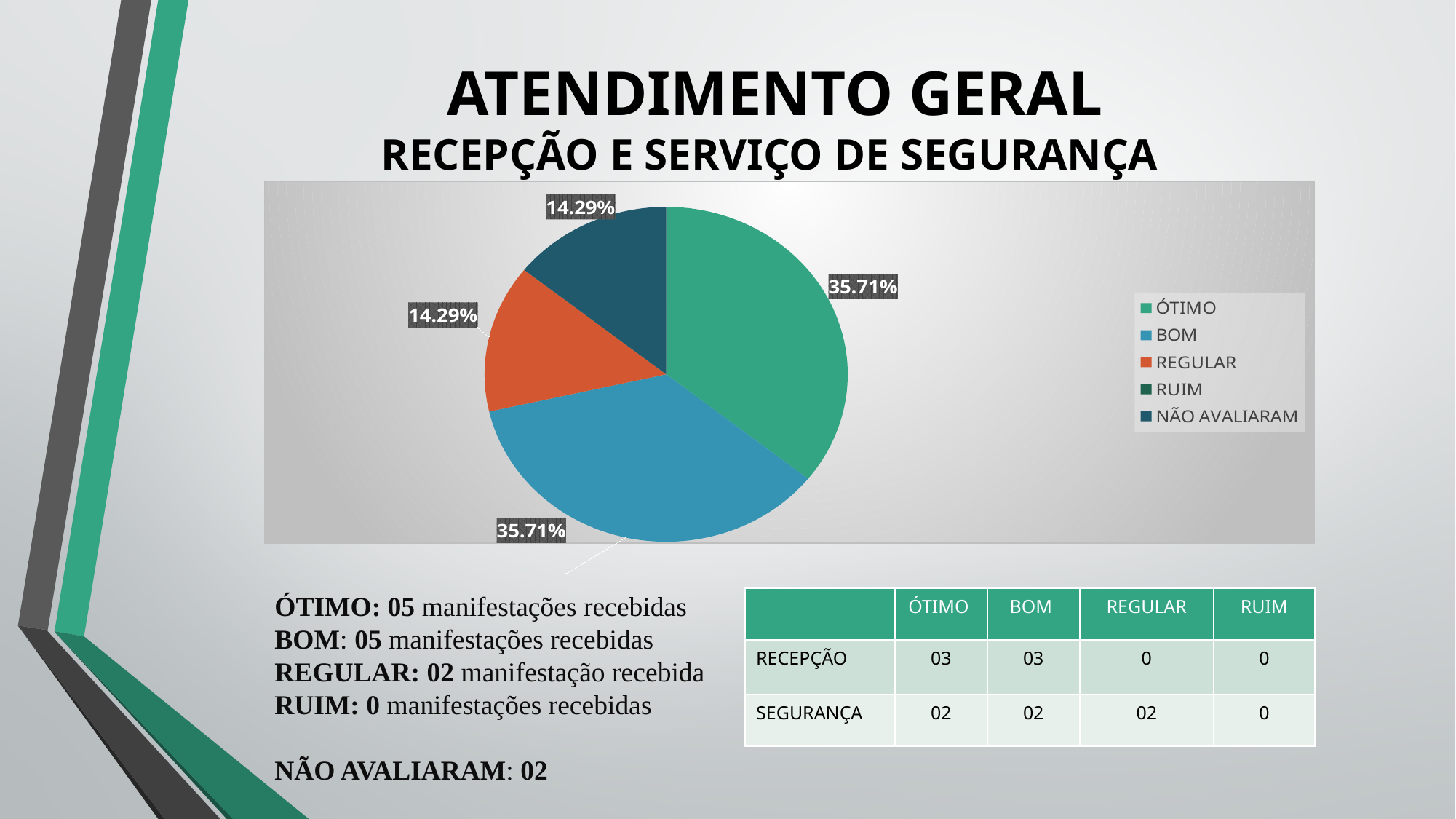
What colour is the ÓTIMO slice in the pie chart? green How many slices are visible in the pie chart? 4 What share of the pie does REGULAR represent? 14.29% Which legend entry of the pie chart is shown in orange? REGULAR Which is larger in the pie chart, ÓTIMO or REGULAR? ÓTIMO What share of the pie does BOM represent? 35.71% What kind of chart is shown on the slide? pie chart What is the difference between the ÓTIMO share and the REGULAR share in the pie chart? 21.42% What share of the pie does NÃO AVALIARAM represent? 14.29% Which is larger in the pie chart, BOM or NÃO AVALIARAM? BOM How many entries does the legend of the pie chart list? 5